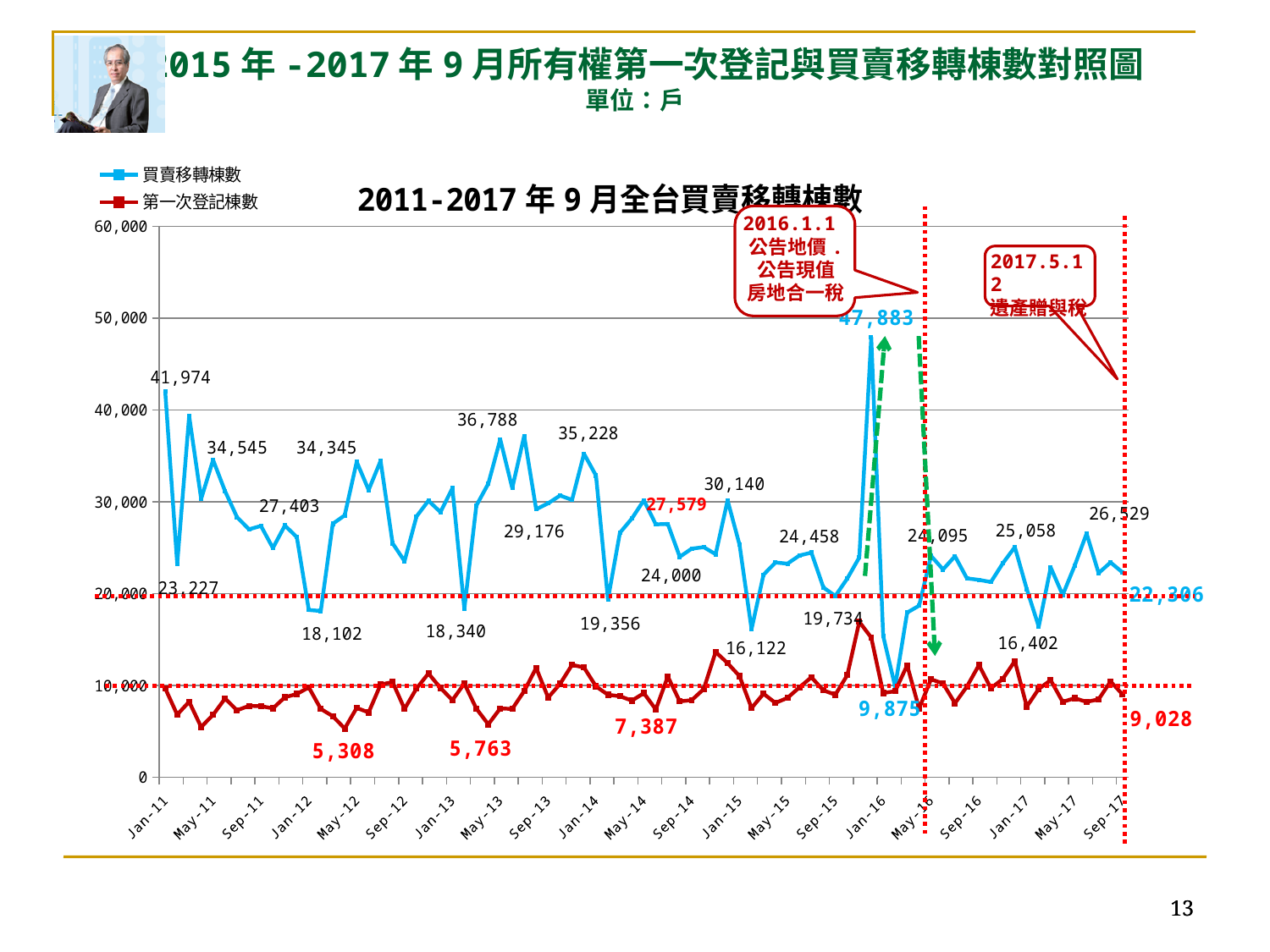
Which labelled 買賣移轉棟數 value is larger, 36,788 or 35,228? 36,788 How many series does the legend list? 2 Is the 買賣移轉棟數 value at Jan-11 greater or less than 40,000? greater What is the title printed above the chart? 2011-2017年9月全台買賣移轉棟數 What are the two series named in the legend? 買賣移轉棟數 and 第一次登記棟數 What is the lowest labelled value of the 第一次登記棟數 series? 5,308 What kind of chart is shown on the slide? line chart What is the difference between the peak value 47,883 and the Jan-11 value 41,974 of 買賣移轉棟數? 5,909 What is the highest labelled value of the 買賣移轉棟數 series? 47,883 What is the difference between the labelled 第一次登記棟數 values 5,763 and 5,308? 455 What is the value of 買賣移轉棟數 at Jan-11? 41,974